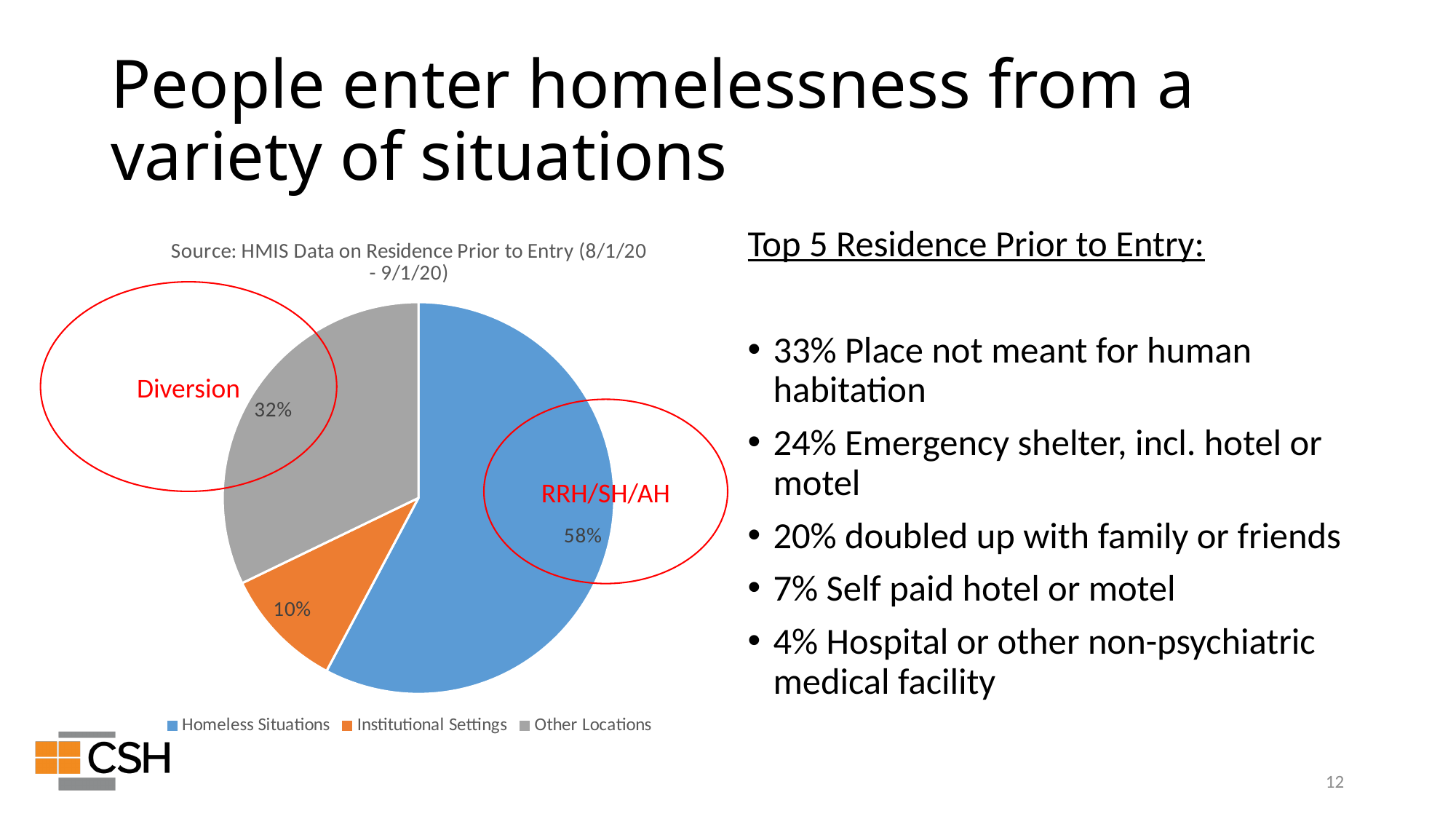
How many slices does the pie chart have? 3 Which category has the largest share of the pie? Homeless Situations Which category has the smallest share of the pie? Institutional Settings What percentage of the pie is Institutional Settings? 10% Which is larger, the share for Other Locations or the share for Institutional Settings? Other Locations What percentage of the pie is Other Locations? 32% What is the title of the pie chart? Source: HMIS Data on Residence Prior to Entry (8/1/20 - 9/1/20) How many entries does the legend list? 3 What is the difference in percentage points between Homeless Situations and Other Locations? 26 What percentage of the pie is Homeless Situations? 58% What is the difference in percentage points between Other Locations and Institutional Settings? 22 What kind of chart is shown on the slide? Pie chart